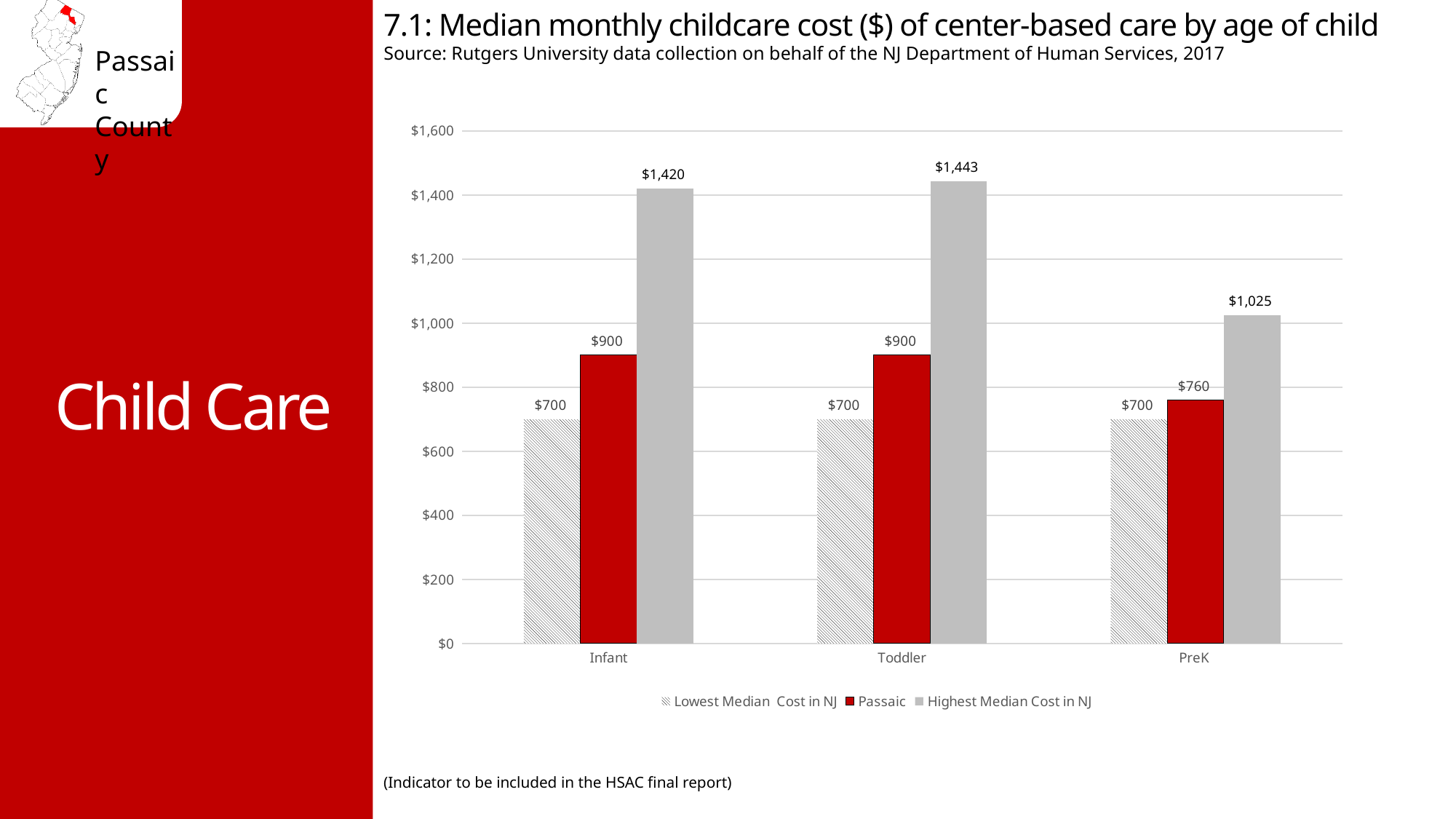
What is the Lowest Median Cost in NJ for PreK care? $700 How many series does the legend list? 3 What is the Passaic median monthly childcare cost for Infant care? $900 Which is larger for PreK care: the Passaic cost or the Lowest Median Cost in NJ? Passaic Which age group has the highest value for the Highest Median Cost in NJ series? Toddler What is the difference between the Highest Median Cost in NJ and the Passaic cost for Infant care? $520 What is the Passaic median monthly cost for PreK care? $760 Which age group has the lowest Passaic median monthly cost? PreK What is the Highest Median Cost in NJ for Toddler care? $1,443 Which series is drawn in red? Passaic How many age groups are shown on the x axis? 3 What kind of chart is shown on the slide? Bar chart